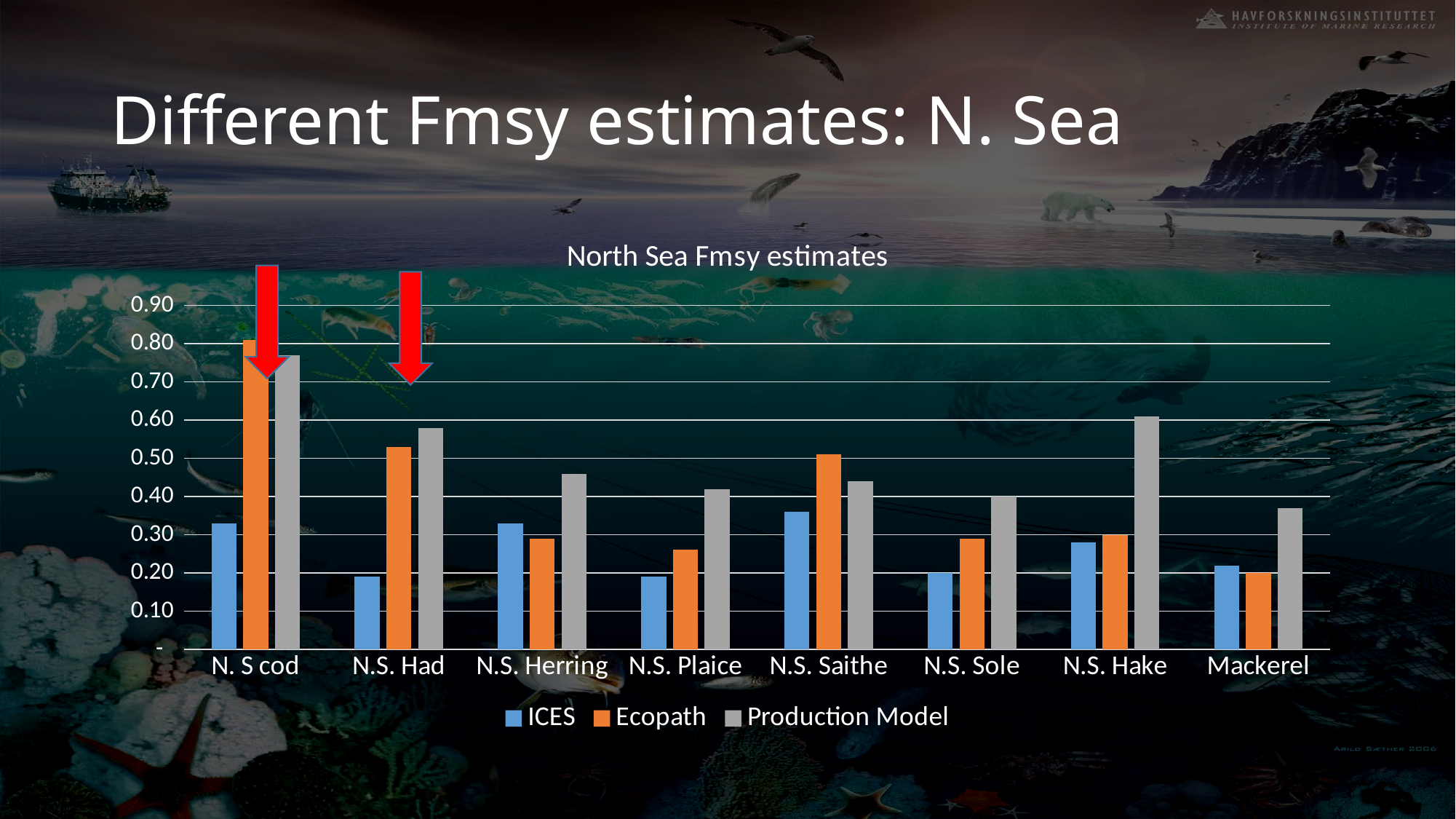
Which series is shown in orange in the legend? Ecopath How many fish stock categories are shown on the x axis? 8 What kind of chart is shown on the slide? bar chart For N.S. Saithe, which is larger: the Ecopath value or the Production Model value? Ecopath Which category has the highest Ecopath value? N. S cod How many series does the legend list? 3 What is the title of the chart? North Sea Fmsy estimates For N.S. Herring, which is larger: the ICES value or the Production Model value? Production Model Which category has the highest Production Model value? N. S cod